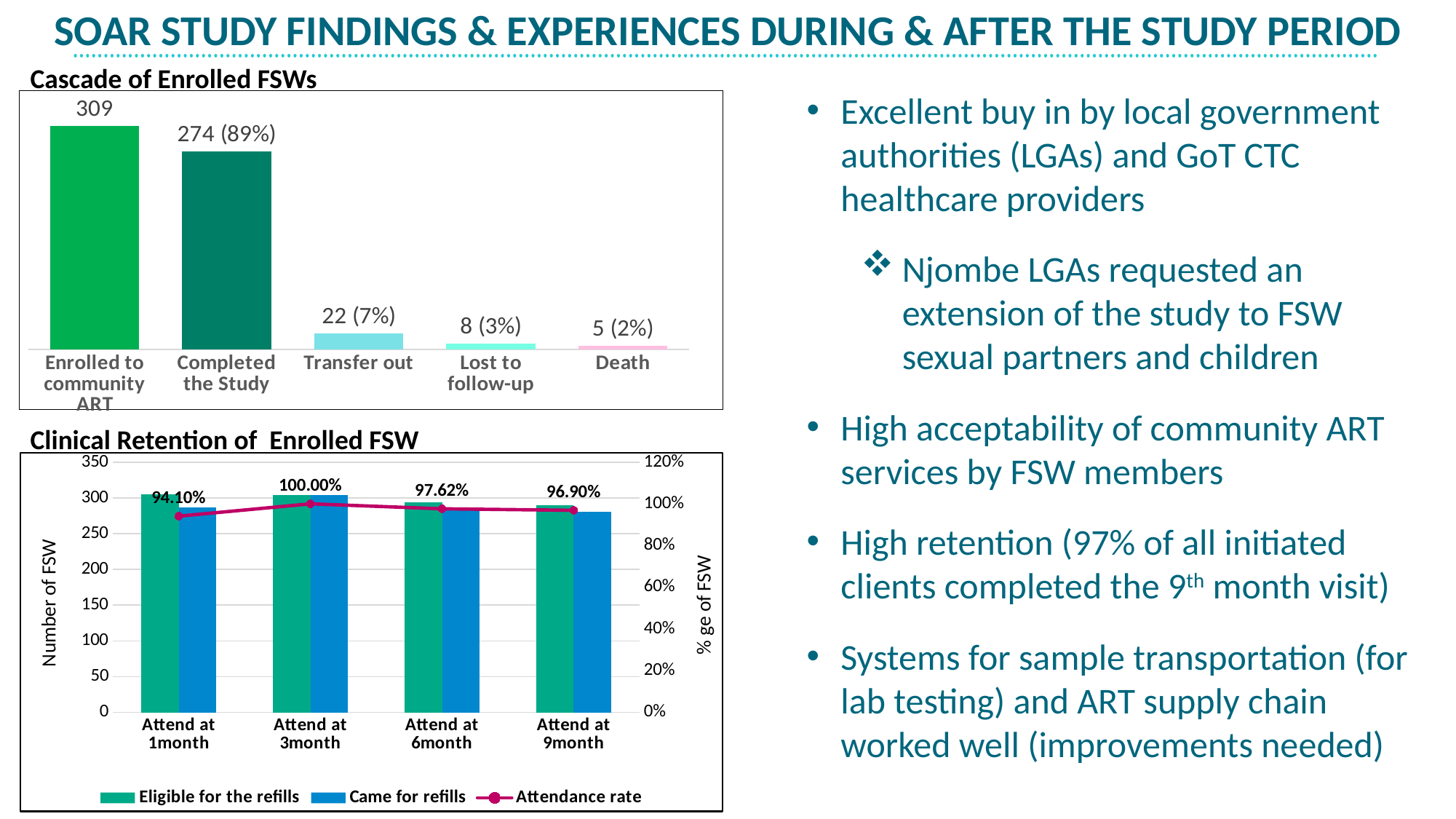
In the 'Clinical Retention of Enrolled FSW' chart, which time point has the lowest attendance rate? Attend at 1month In the 'Cascade of Enrolled FSWs' chart, what is the data label for 'Completed the Study'? 274 (89%) In the 'Cascade of Enrolled FSWs' chart, which category has the lowest value? Death In the 'Cascade of Enrolled FSWs' chart, what is the difference between 'Enrolled to community ART' and 'Completed the Study'? 35 In the 'Clinical Retention of Enrolled FSW' chart, is the 'Came for refills' value at 'Attend at 1month' greater or less than 250? greater In the 'Clinical Retention of Enrolled FSW' chart, how many series does the legend list? 3 In the 'Cascade of Enrolled FSWs' chart, how many categories are shown? 5 In the 'Cascade of Enrolled FSWs' chart, what is the data label for 'Transfer out'? 22 (7%) In the 'Clinical Retention of Enrolled FSW' chart, what is the attendance rate at 'Attend at 1month'? 94.10% In the 'Clinical Retention of Enrolled FSW' chart, what is the attendance rate at 'Attend at 3month'? 100.00% In the 'Cascade of Enrolled FSWs' chart, which is larger: 'Lost to follow-up' or 'Death'? Lost to follow-up In the 'Cascade of Enrolled FSWs' chart, what is the value for 'Enrolled to community ART'? 309